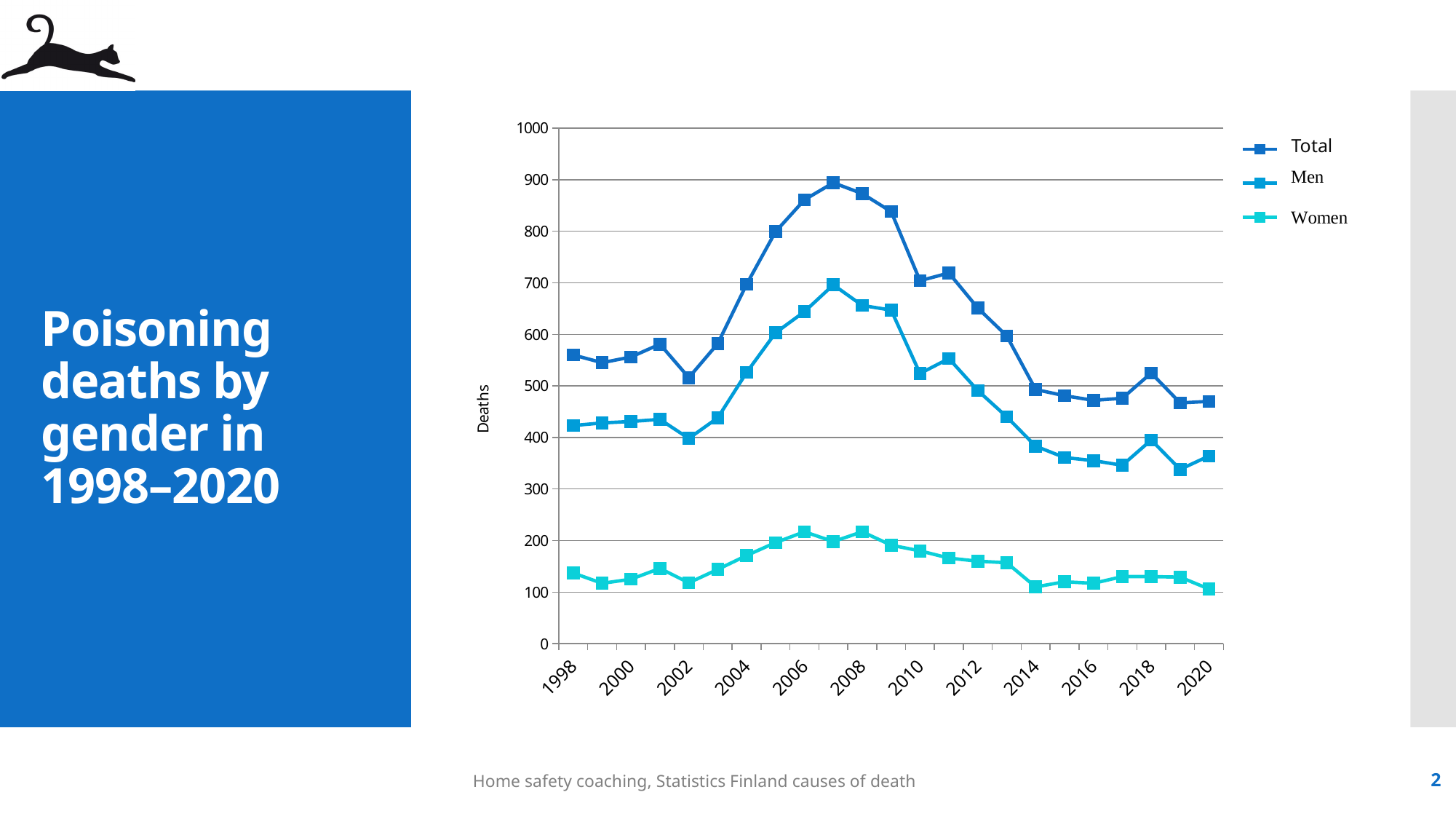
How many series does the legend list? 3 Is the value for Women in 2020 greater or less than 200? less Which series has the lowest values throughout the chart? Women Is the value for Men in 2002 greater or less than 500? less Which series has the highest values throughout the chart? Total Is the value for Total in 1998 greater or less than 500? greater How many yearly data points does each series have? 23 Which is larger, the value for Men in 2006 or the value for Men in 2014? 2006 Do the Total values rise or fall between 2002 and 2006? rise What kind of chart is shown on the slide? Line chart What is the label on the vertical axis? Deaths